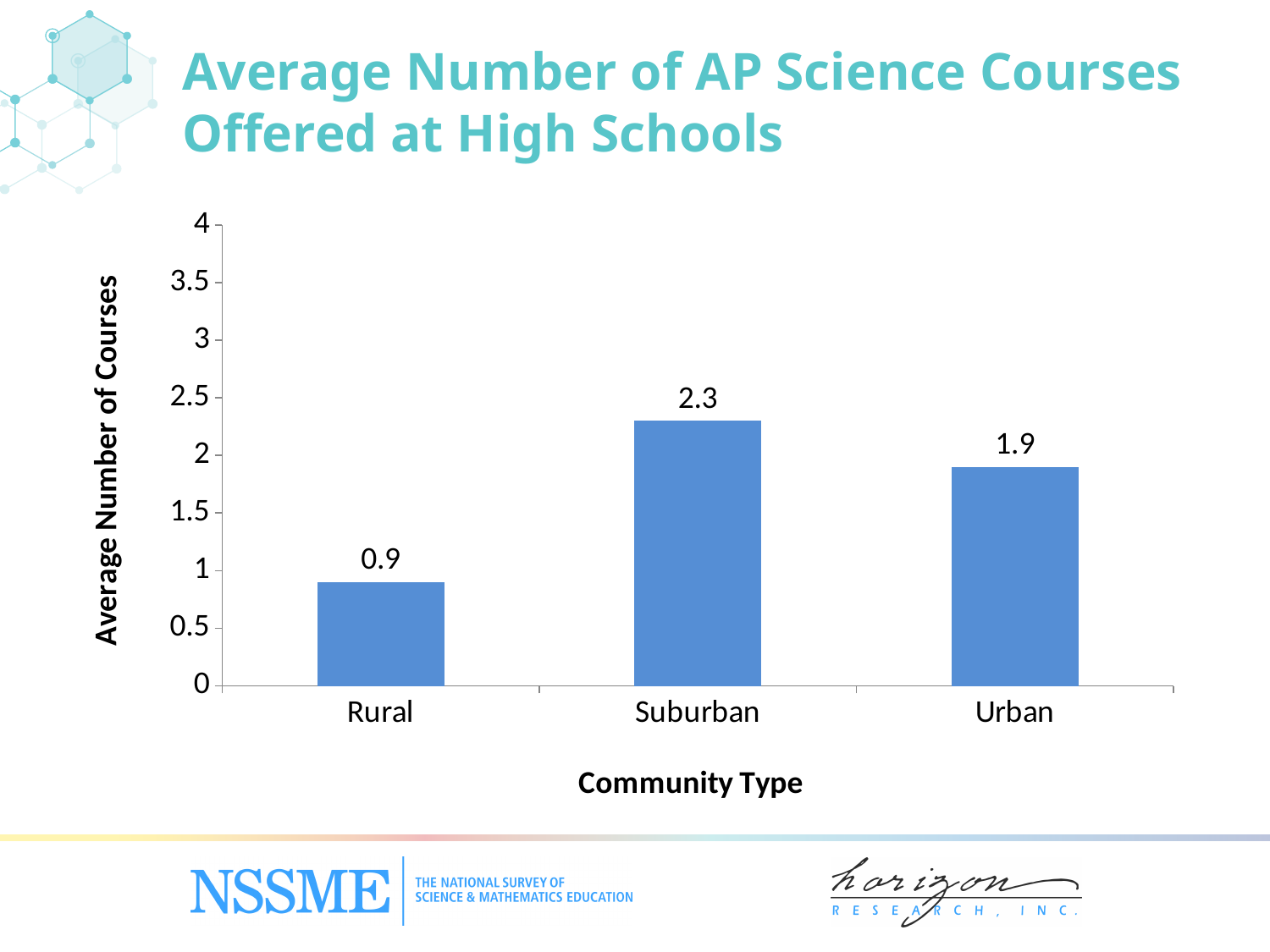
What is the average number of AP science courses offered at rural high schools? 0.9 Which community type has the highest average number of AP science courses? Suburban What is the average number of AP science courses offered at urban high schools? 1.9 How many community types are shown on the chart? 3 Which has a higher average number of AP science courses, urban or rural high schools? Urban Is the value for Urban greater or less than 1.5? greater What is the difference between the average number of AP science courses at suburban and urban high schools? 0.4 What kind of chart is shown on the slide? Bar chart What is the difference between the average number of AP science courses at suburban and rural high schools? 1.4 What is the average number of AP science courses offered at suburban high schools? 2.3 What is the label of the x axis? Community Type Which community type has the lowest average number of AP science courses? Rural